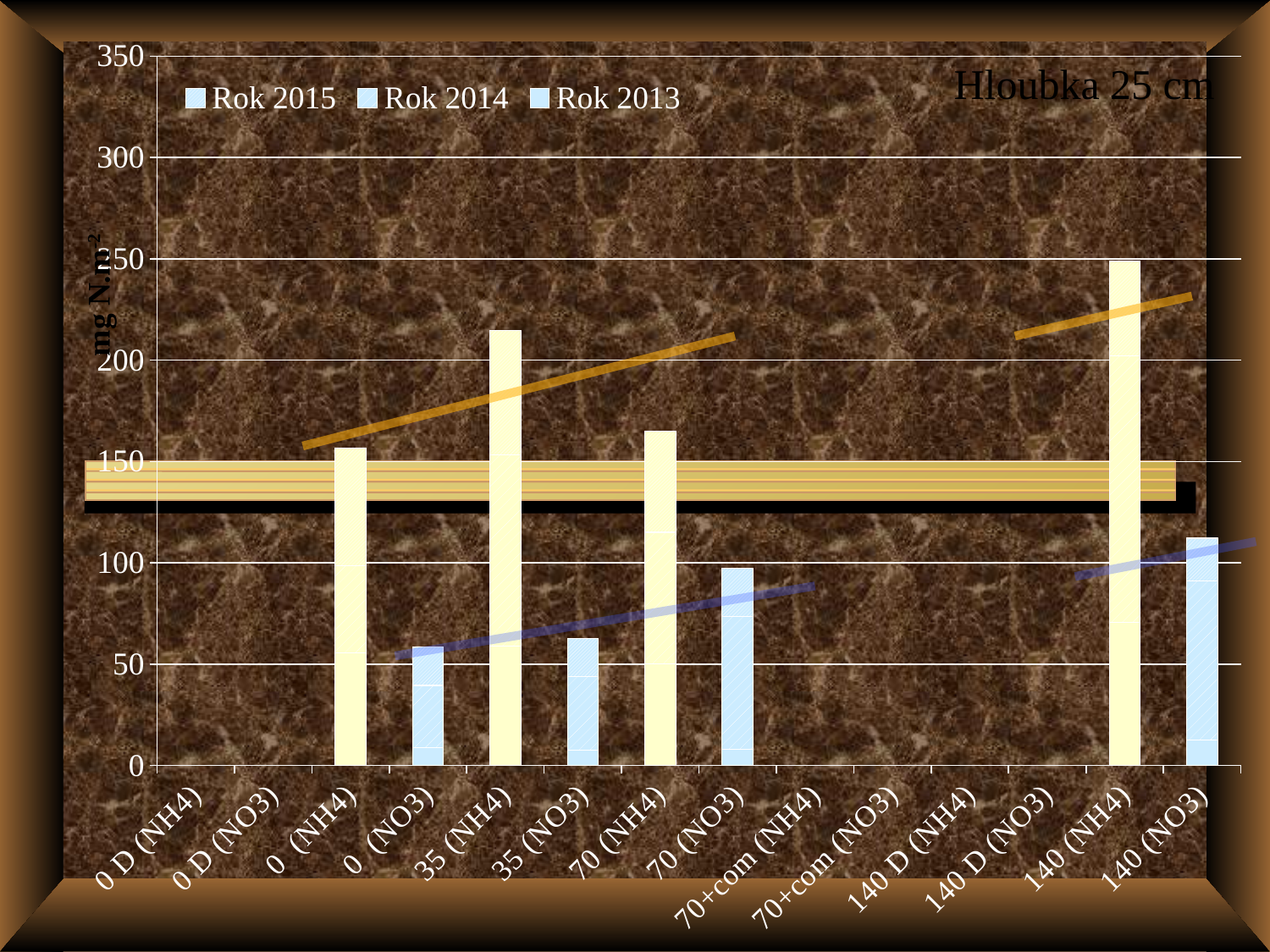
Is the value for 140 (NO3) greater or less than 100? greater What kind of chart is shown on the slide? bar chart How many series does the legend list? 3 Which is larger, the bar for 35 (NH4) or the bar for 70 (NH4)? 35 (NH4) Is the value for 140 (NH4) greater or less than 200? greater Which is larger, the bar for 70 (NO3) or the bar for 0 (NO3)? 70 (NO3) Is the value for 35 (NH4) greater or less than 200? greater Which category has the highest bar? 140 (NH4) What is the title of the chart? Hloubka 25 cm How many categories are shown on the x axis? 14